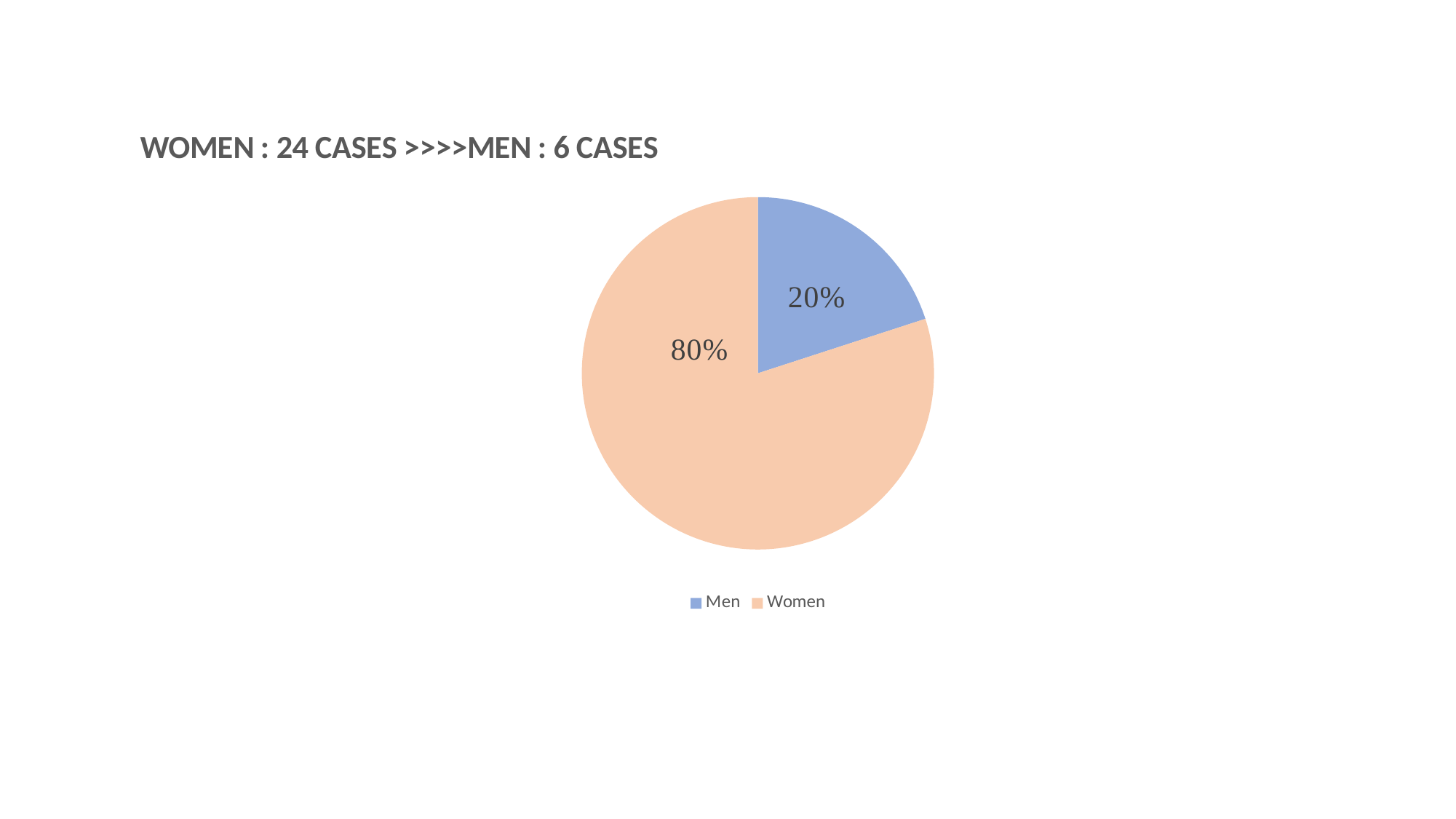
What kind of chart is shown on the slide? Pie chart Which slice is larger, Men or Women? Women What is the title text shown above the chart? WOMEN : 24 CASES >>>>MEN : 6 CASES What is the difference in percentage points between the Women slice and the Men slice? 60 percentage points How many entries does the legend list? 2 Which category has the largest slice of the pie? Women Which category has the smallest slice of the pie? Men Is the share for Women greater or less than 50%? greater What share of the pie does the Men slice represent? 20% How many slices does the pie chart have? 2 What share of the pie does the Women slice represent? 80% What colour is the Men slice in the pie chart? Blue